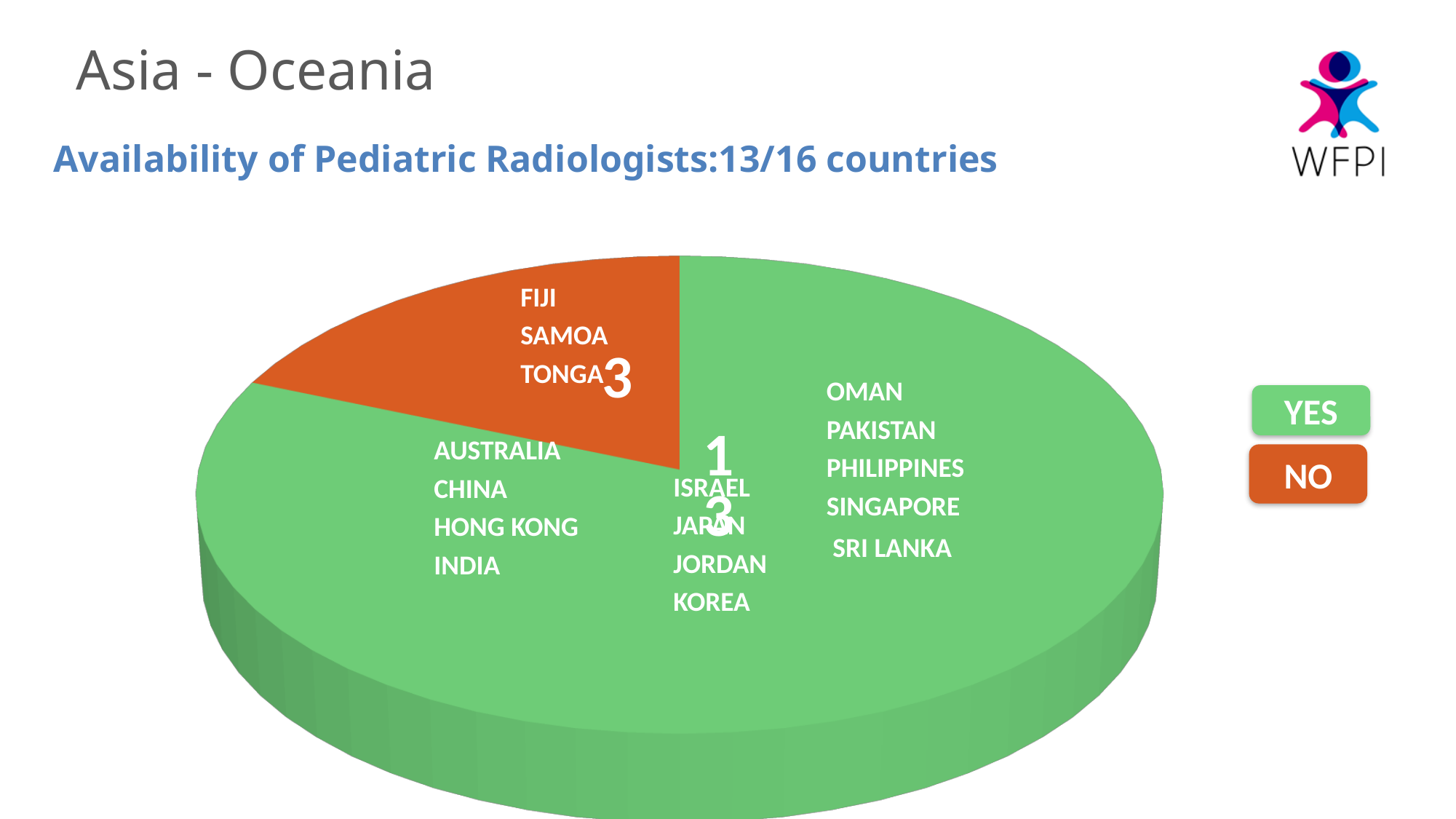
What is the value of the YES slice? 13 Which slice is the largest? YES What is the difference between the YES value and the NO value? 10 What share of the pie does the NO slice represent? 18.75% What is the value of the NO slice? 3 Which slice is the smallest? NO How many slices does the pie chart have? 2 What kind of chart is shown on the slide? pie chart Which countries are listed in the NO slice? Fiji, Samoa, Tonga Which colour represents the NO category in the pie chart? orange Which is larger, the YES slice or the NO slice? YES How many entries does the legend list? 2